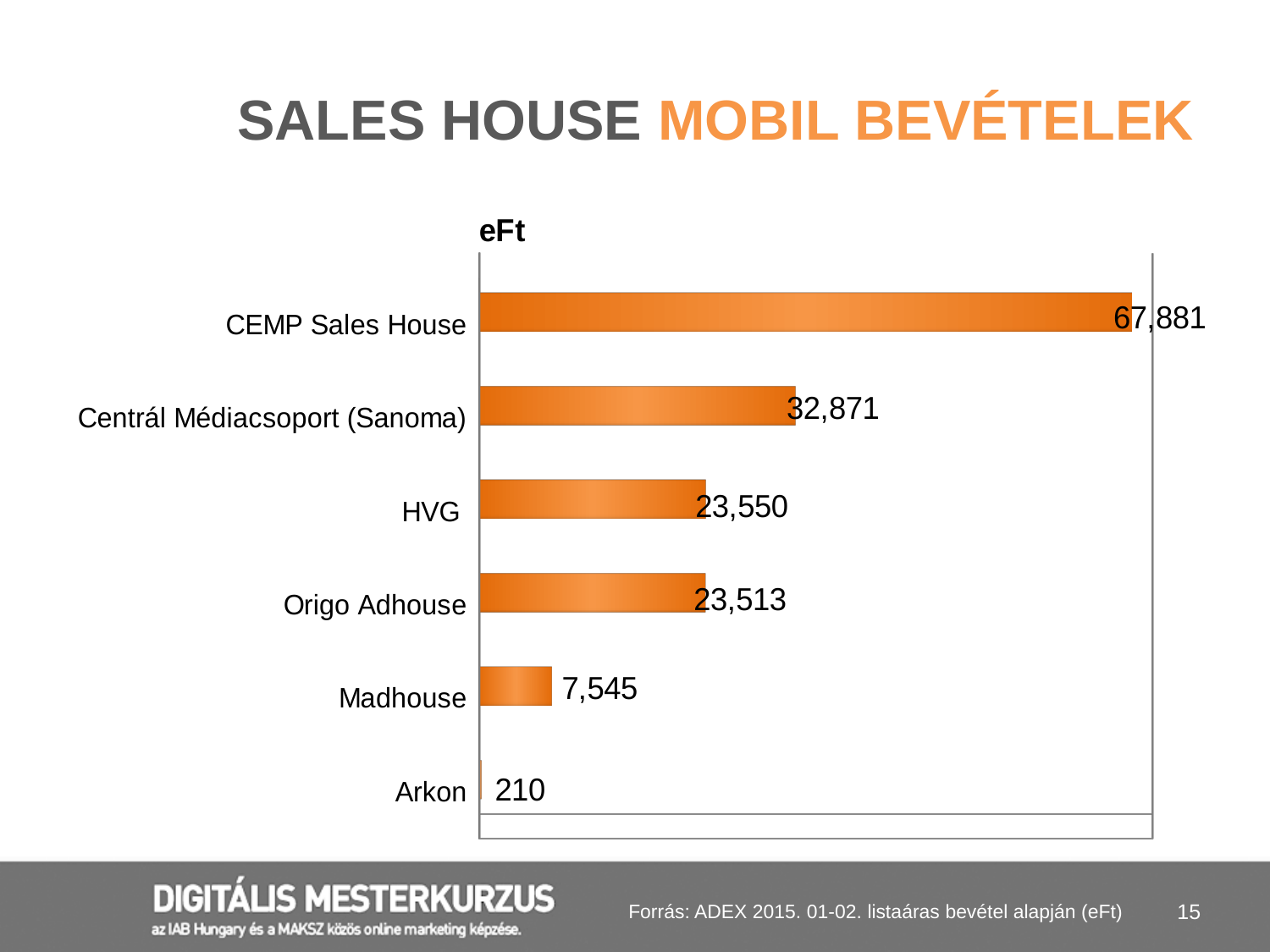
Which sales house has the highest mobile revenue? CEMP Sales House What is the value for Madhouse? 7,545 What is the value for Arkon? 210 What is the value for Centrál Médiacsoport (Sanoma)? 32,871 What unit is indicated above the chart? eFt Which sales house has the lowest mobile revenue? Arkon Which is larger, the value for Madhouse or the value for Arkon? Madhouse What is the value for CEMP Sales House? 67,881 What is the difference between the values for HVG and Origo Adhouse? 37 What is the difference between the values for CEMP Sales House and Centrál Médiacsoport (Sanoma)? 35,010 What kind of chart is shown on the slide? Bar chart How many sales houses are shown in the chart? 6